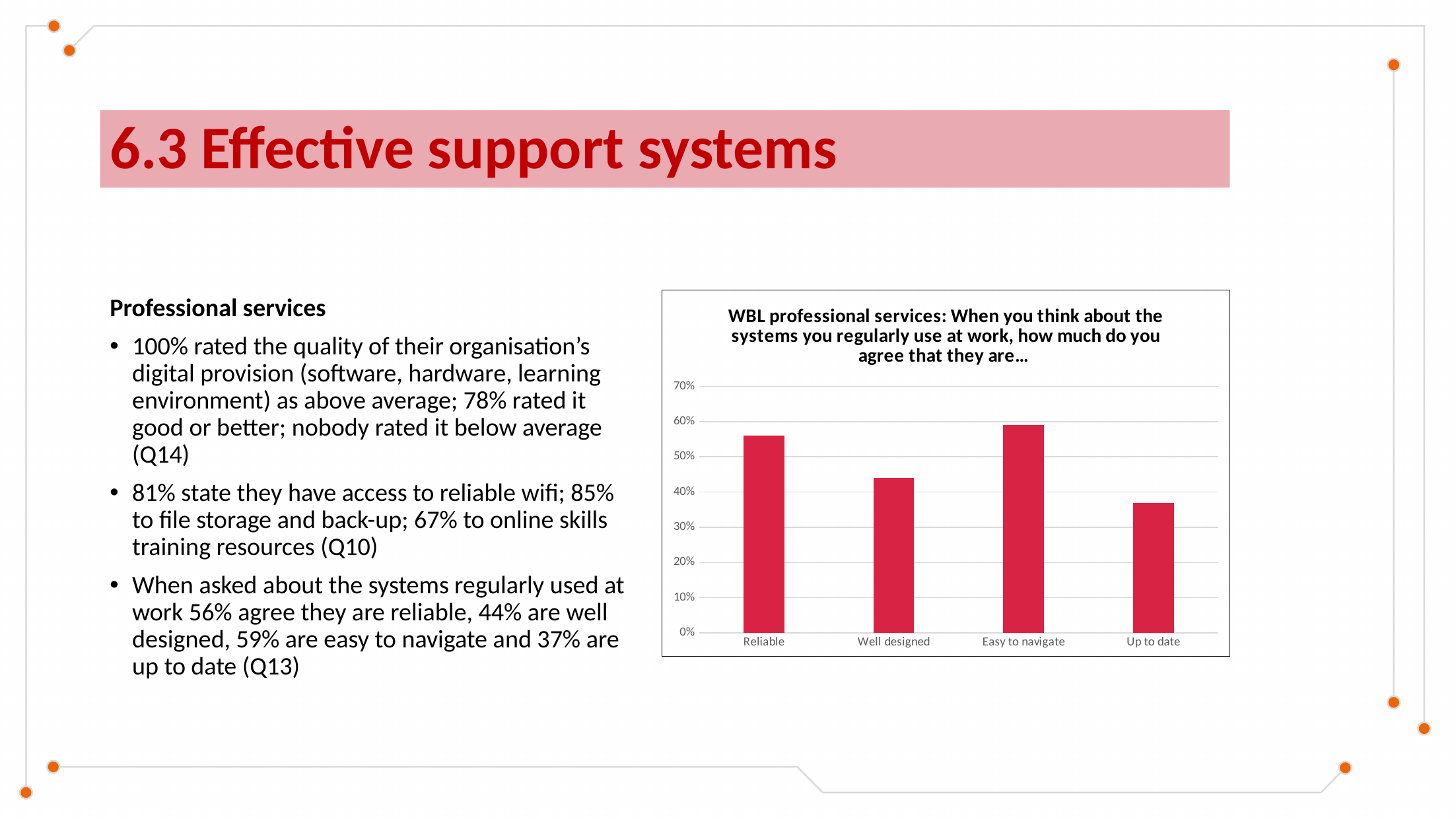
Is the value for Reliable greater or less than 50%? greater Is the value for Easy to navigate greater or less than 60%? less What colour are the bars in the chart? red Is the value for Up to date greater or less than 40%? less Which category has the lowest bar in the chart? Up to date Which is larger, the value for Easy to navigate or the value for Up to date? Easy to navigate How many categories are shown on the x axis of the chart? 4 What is the highest value shown on the chart's vertical axis? 70% What kind of chart is shown on the slide? bar chart Which is larger, the value for Reliable or the value for Well designed? Reliable